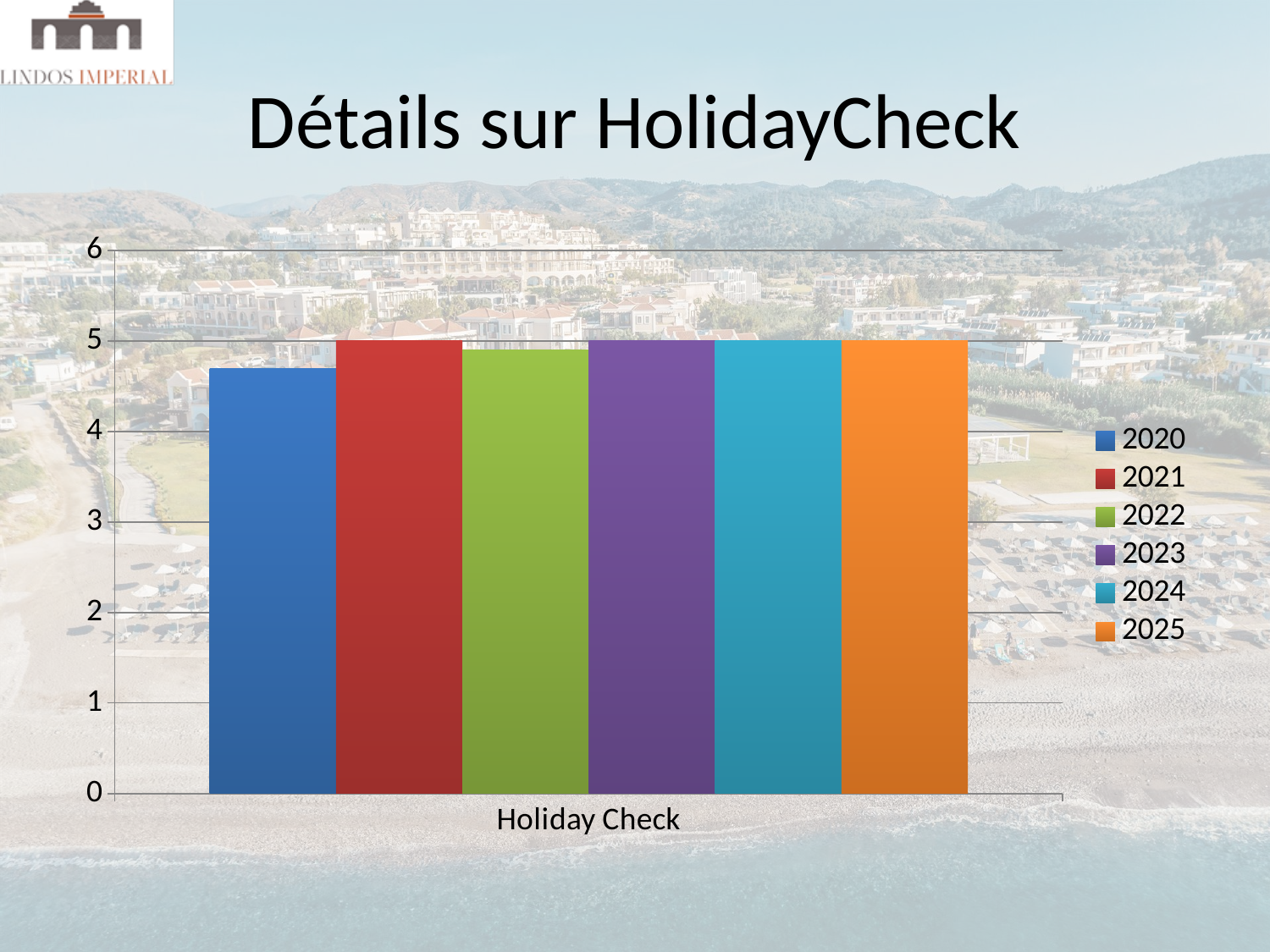
What kind of chart is shown on the slide? bar chart Which is larger, the value for 2022 or the value for 2020? 2022 Is the value for 2020 greater or less than 4? greater What is the category label on the x axis? Holiday Check How many categories are shown on the x axis? 1 Which year has the lowest value for Holiday Check? 2020 What is the title of the slide containing the chart? Détails sur HolidayCheck How many series does the legend list? 6 What is the value for 2024 for Holiday Check? 5 Is the value for 2020 greater or less than 5? less Which is larger, the value for 2021 or the value for 2020? 2021 What is the value for 2021 for Holiday Check? 5